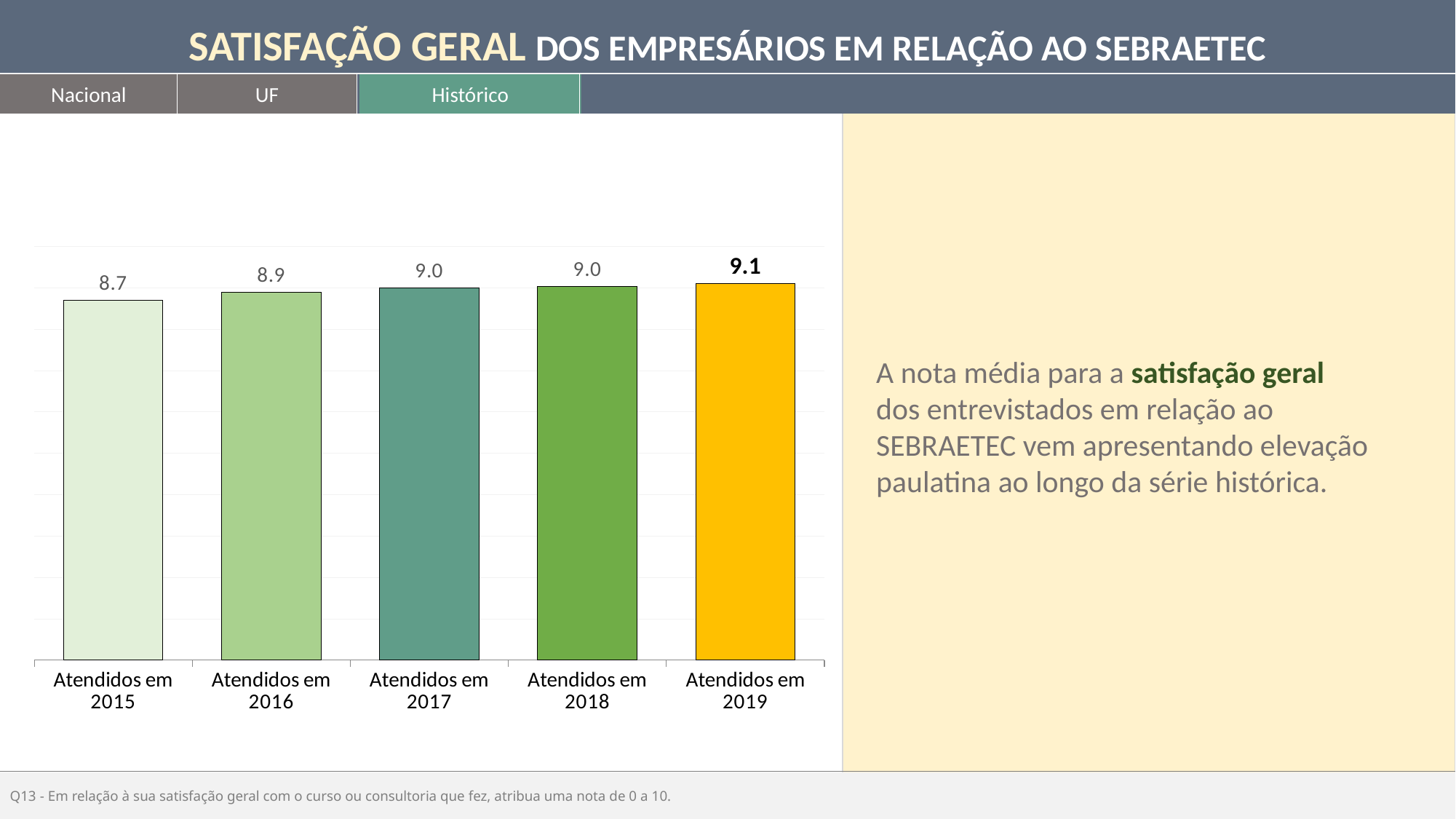
What kind of chart is shown on the slide? Bar chart What is the value for Atendidos em 2016? 8.9 Which is larger, the value for Atendidos em 2016 or Atendidos em 2019? Atendidos em 2019 What is the value for Atendidos em 2015? 8.7 What is the difference between the values for Atendidos em 2019 and Atendidos em 2015? 0.4 What is the difference between the values for Atendidos em 2016 and Atendidos em 2015? 0.2 What is the value for Atendidos em 2019? 9.1 What is the value for Atendidos em 2018? 9.0 Do the values rise or fall from 2015 to 2019? Rise Which category has the lowest value? Atendidos em 2015 How many categories are shown in the chart? 5 Which category has the highest value? Atendidos em 2019